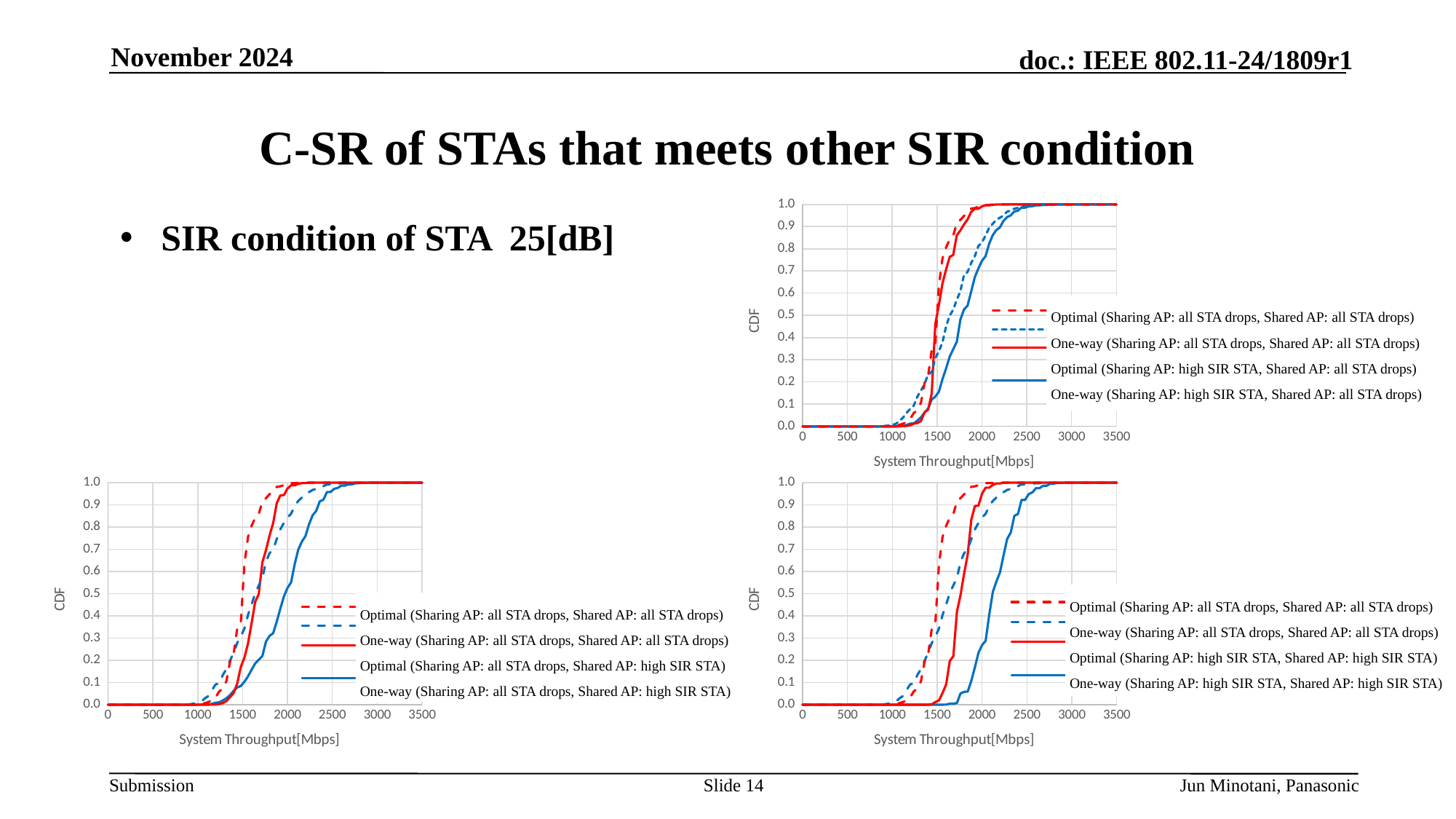
How many series does the legend of the bottom-right chart list? 4 What kind of chart is the bottom-left chart? Line chart In the bottom-left chart, at 1500 Mbps, which line has the higher CDF: 'Optimal (Sharing AP: all STA drops, Shared AP: all STA drops)' or 'One-way (Sharing AP: all STA drops, Shared AP: high SIR STA)'? Optimal (Sharing AP: all STA drops, Shared AP: all STA drops) In the top-right chart, is the CDF of the 'One-way (Sharing AP: high SIR STA, Shared AP: all STA drops)' line at 1500 Mbps greater or less than 0.5? less How many series does the legend of the top-right chart list? 4 In the bottom-right chart, is the CDF of the 'Optimal (Sharing AP: all STA drops, Shared AP: all STA drops)' line at 2000 Mbps greater or less than 0.9? greater In the bottom-right chart, do the CDF values rise or fall as System Throughput increases? Rise What is the x-axis label of the bottom-left chart? System Throughput[Mbps] In the bottom-right chart, at 2000 Mbps, which line has the higher CDF: 'Optimal (Sharing AP: all STA drops, Shared AP: all STA drops)' or 'One-way (Sharing AP: high SIR STA, Shared AP: high SIR STA)'? Optimal (Sharing AP: all STA drops, Shared AP: all STA drops) In the bottom-right chart, is the CDF of the 'One-way (Sharing AP: high SIR STA, Shared AP: high SIR STA)' line at 1500 Mbps greater or less than 0.1? less What is the y-axis label of the top-right chart? CDF